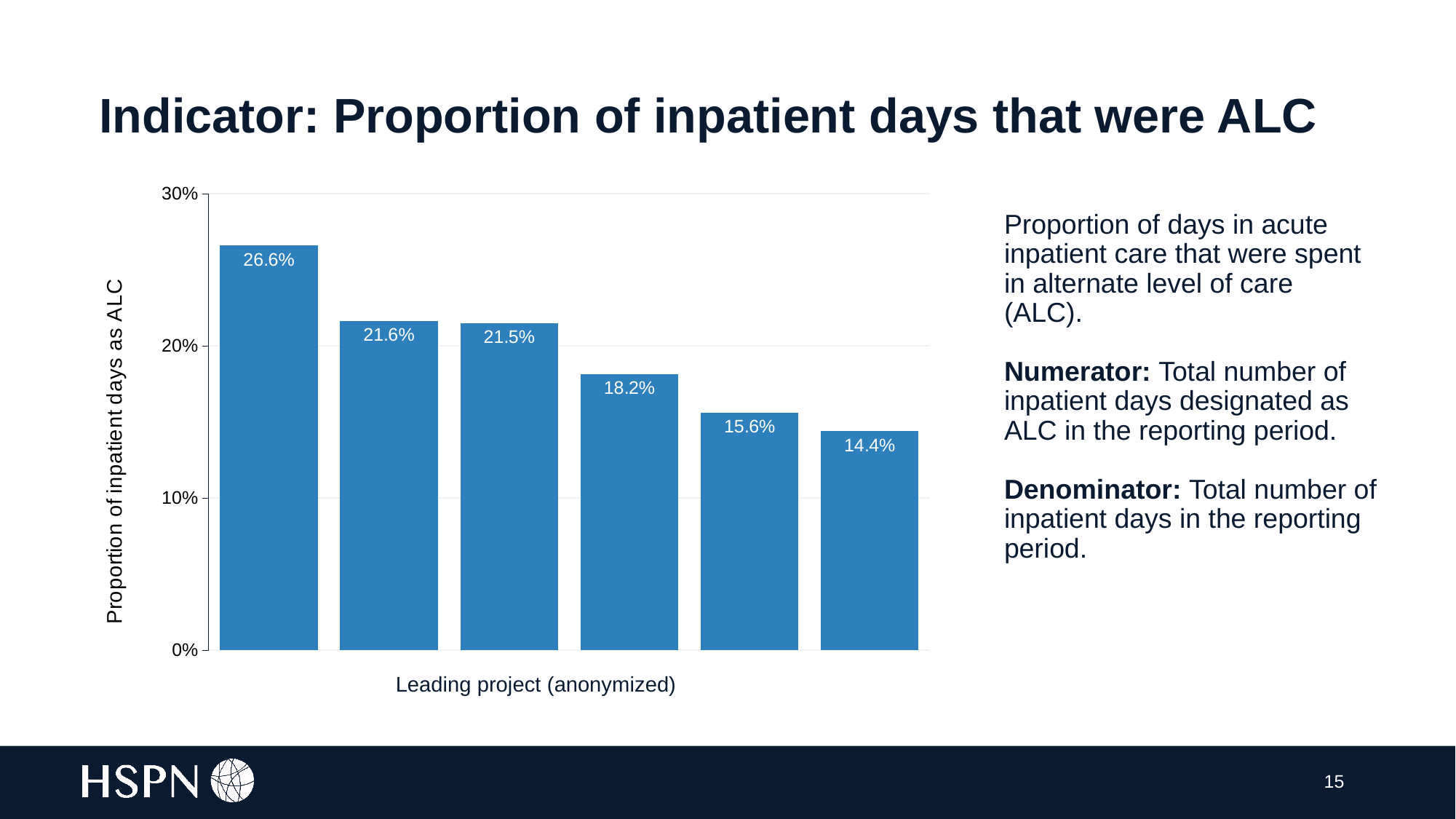
What is the label on the y axis of the chart? Proportion of inpatient days as ALC What is the highest value shown in the chart? 26.6% What is the difference between the leftmost bar's value and the rightmost bar's value? 12.2% What is the lowest value shown in the chart? 14.4% What is the label on the x axis of the chart? Leading project (anonymized) What kind of chart is shown on the slide? bar chart What is the value shown on the fourth bar from the left? 18.2% What is the value shown on the leftmost bar? 26.6% Which is larger, the value of the fourth bar from the left or the fifth bar from the left? the fourth bar (18.2%) What is the value shown on the rightmost bar? 14.4% How many bars are plotted in the chart? 6 Do the bar values rise or fall from left to right along the x axis? fall